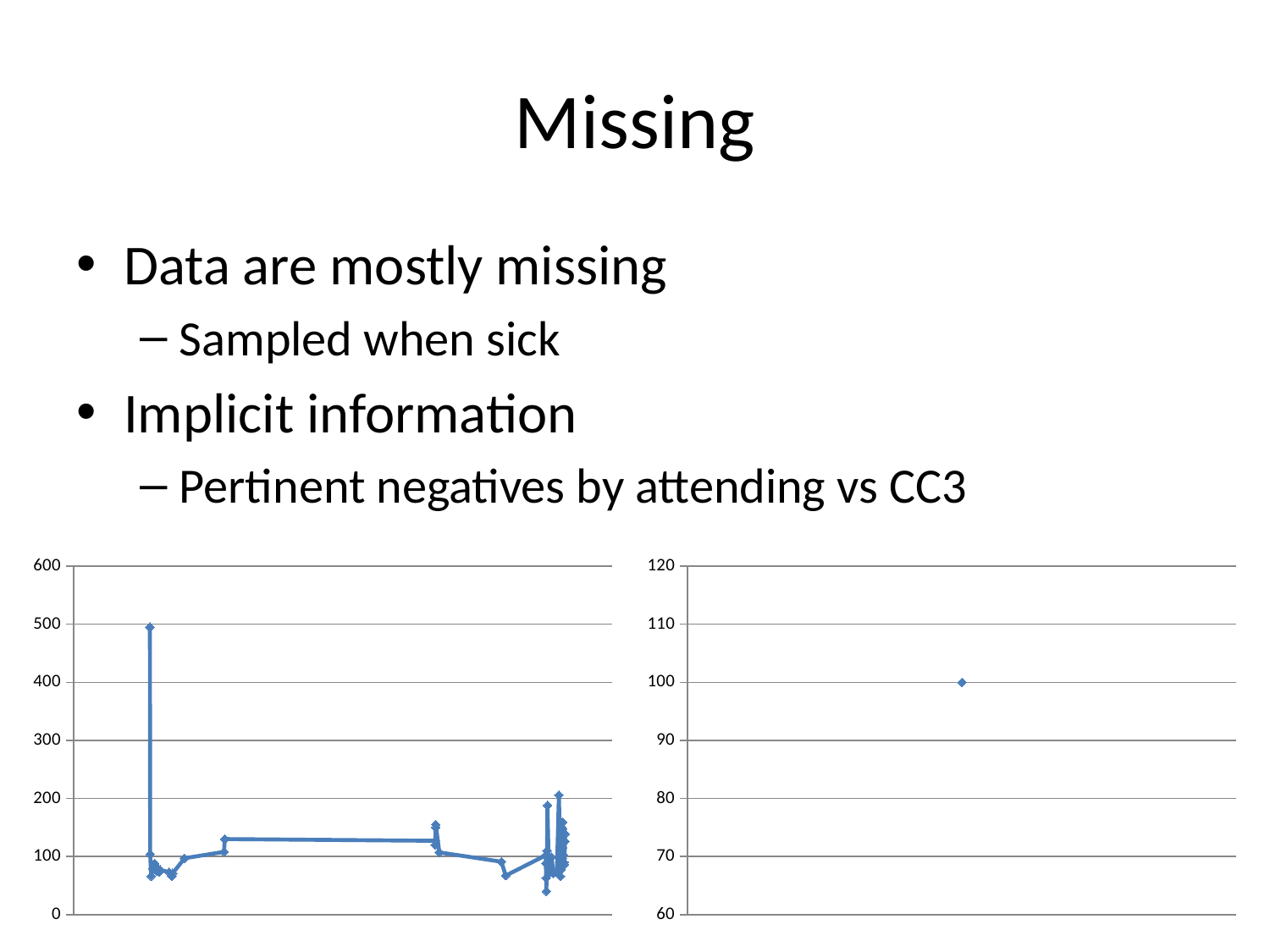
In the chart on the left, is the highest plotted value greater or less than 600? less What is the maximum value shown on the vertical axis of the chart on the left? 600 What kind of chart is the chart on the left of the slide? line chart In the chart on the right, how many data points are plotted? 1 What kind of chart is the chart on the right of the slide? scatter chart In the chart on the right, is the plotted point greater or less than 110? less In the chart on the right, is the plotted point greater or less than 90? greater In the chart on the right, what value does the single plotted point have on the vertical axis? 100 What is the minimum value shown on the vertical axis of the chart on the right? 60